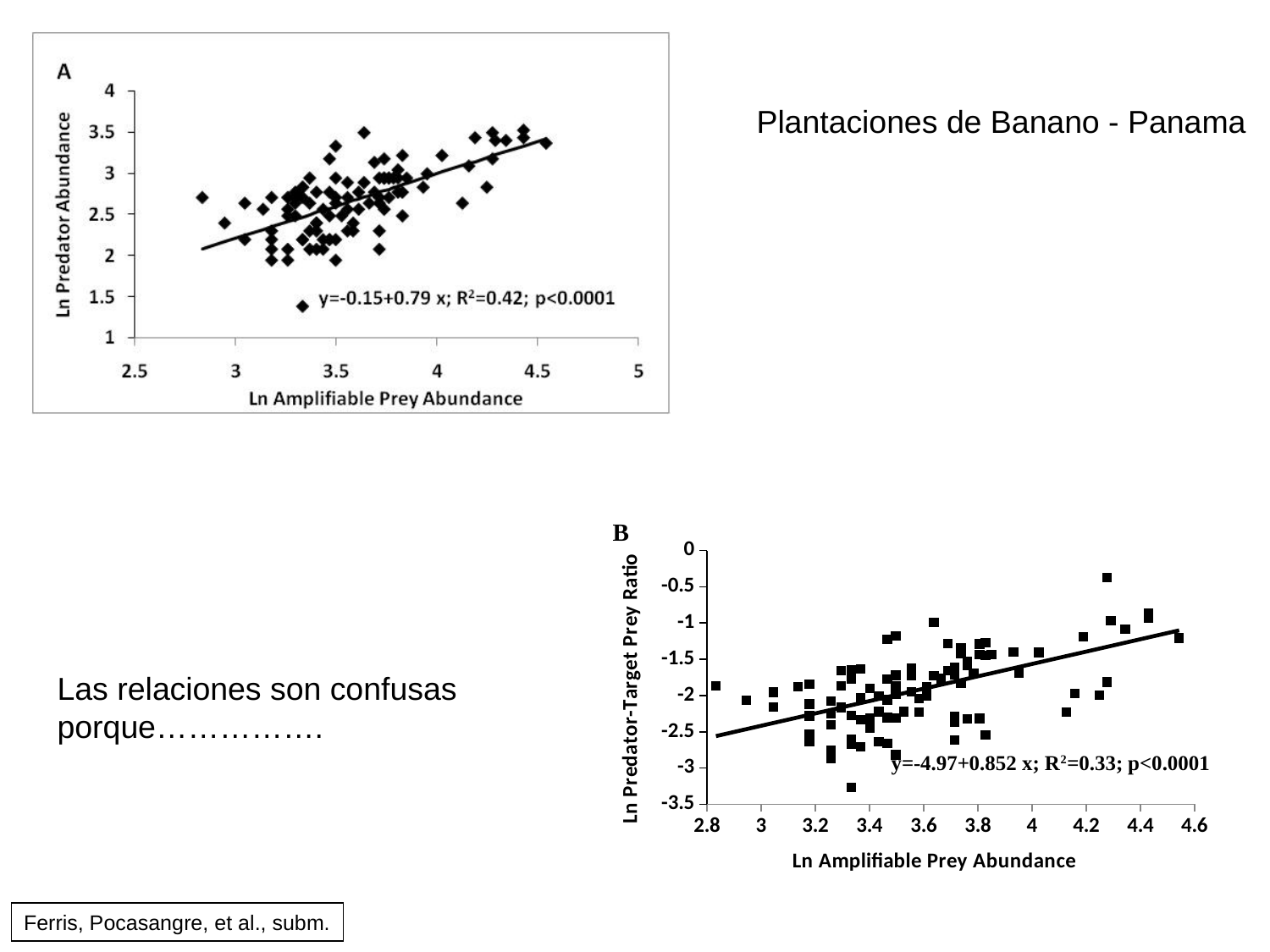
What R² value is printed on chart B? 0.33 In chart A, is the y value of the lowest plotted point greater or less than 1.5? less In chart A, does Ln Predator Abundance generally rise or fall as Ln Amplifiable Prey Abundance increases? rise What R² value is printed on chart A? 0.42 What kind of chart is chart A (top left)? scatter chart What regression equation is printed on chart A? y=-0.15+0.79 x In chart B, does Ln Predator-Target Prey Ratio generally rise or fall as Ln Amplifiable Prey Abundance increases? rise What is the slope in the regression equation printed on chart B? 0.852 What is the x-axis title of chart A? Ln Amplifiable Prey Abundance What is the y-axis title of chart B? Ln Predator-Target Prey Ratio In chart B, is the y value of the highest plotted point greater or less than -1? greater What kind of chart is chart B (bottom right)? scatter chart